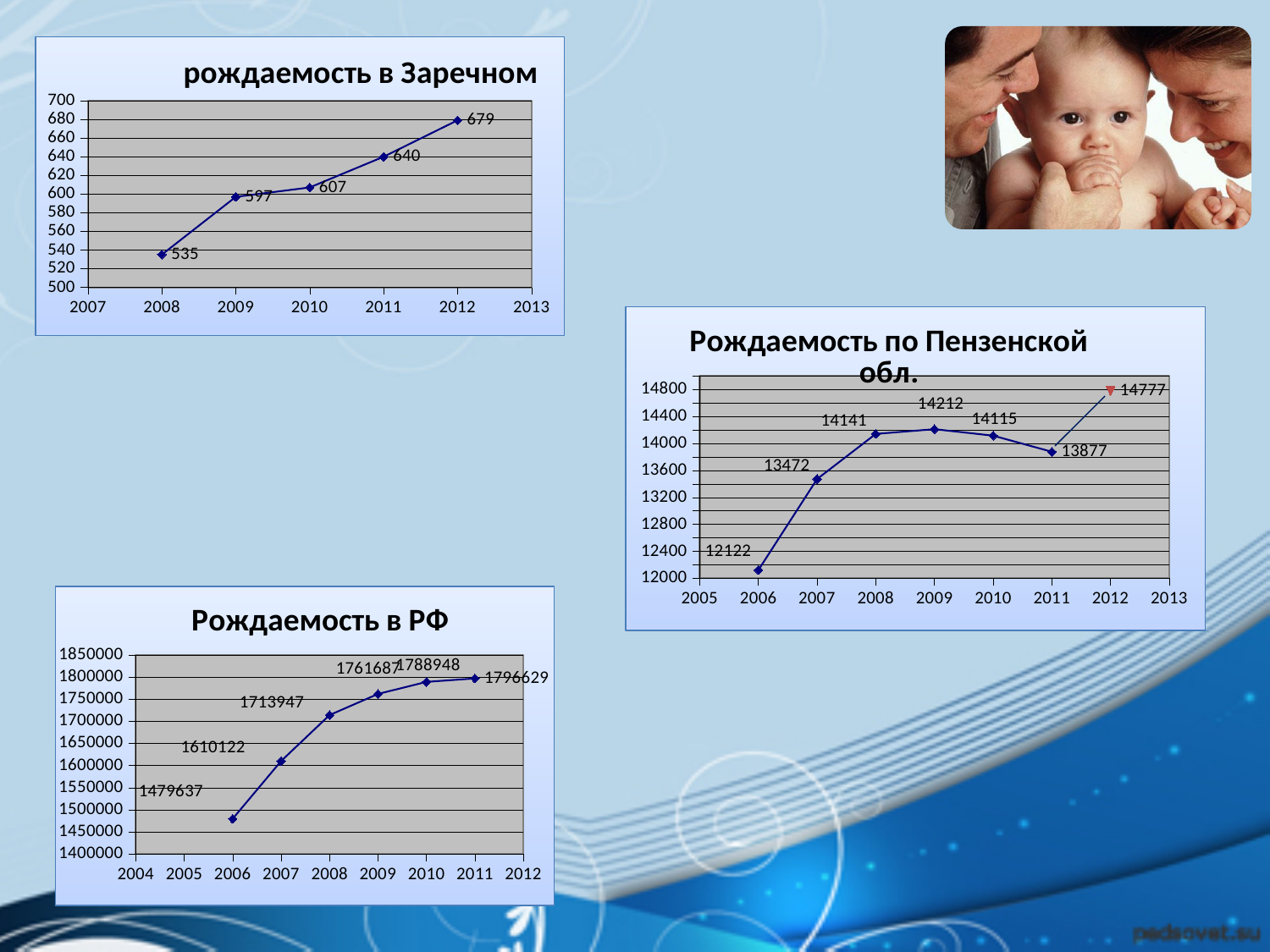
In the chart 'Рождаемость по Пензенской обл.', what is the value for 2009? 14212 In the chart 'Рождаемость по Пензенской обл.', which is larger, the value for 2008 or the value for 2010? 2008 In the chart 'Рождаемость по Пензенской обл.', which year has the highest value? 2012 What type of chart is 'Рождаемость в РФ'? line chart In the chart 'рождаемость в Заречном', which year has the lowest value? 2008 In the chart 'рождаемость в Заречном', how many data points are plotted? 5 In the chart 'Рождаемость по Пензенской обл.', is the value for 2011 greater or less than 14000? less In the chart 'рождаемость в Заречном', what is the difference between the values for 2012 and 2008? 144 In the chart 'Рождаемость в РФ', how many data points are plotted? 6 In the chart 'рождаемость в Заречном', what is the value for 2012? 679 In the chart 'Рождаемость в РФ', what is the value for 2007? 1610122 In the chart 'Рождаемость в РФ', do the values rise or fall from 2006 to 2011? rise